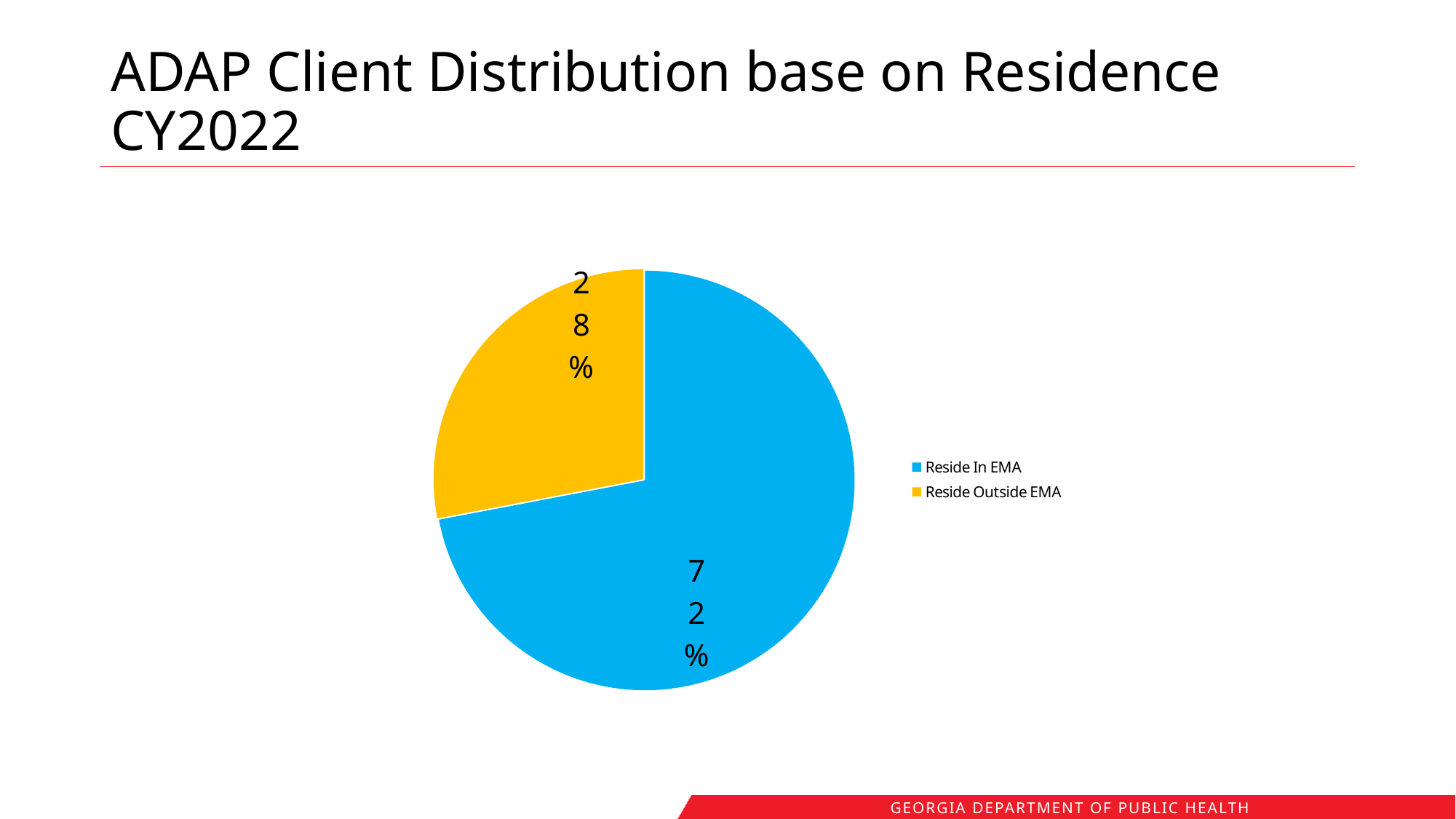
What share of ADAP clients reside outside the EMA? 28% Which category has the smallest share of the pie? Reside Outside EMA What is the title of the slide? ADAP Client Distribution base on Residence CY2022 Which is larger, the share for Reside In EMA or Reside Outside EMA? Reside In EMA What share of ADAP clients reside in the EMA? 72% What is the difference in percentage points between Reside In EMA and Reside Outside EMA? 44 How many categories does the pie chart show? 2 How many entries does the legend list? 2 What colour is the Reside Outside EMA slice? Yellow What kind of chart is shown on the slide? Pie chart Which category has the largest share of the pie? Reside In EMA What is the combined share of the two slices? 100%